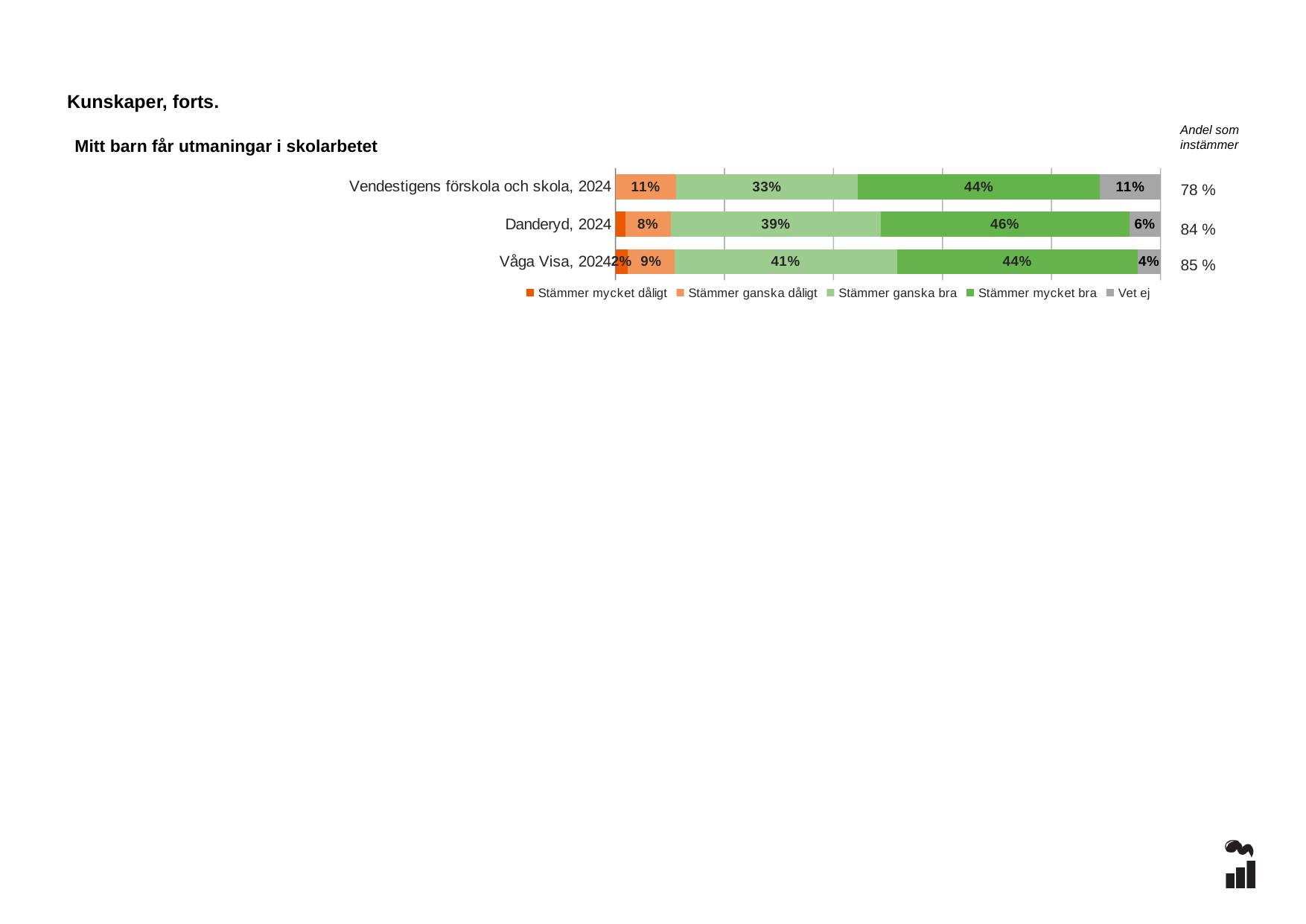
How many categories (bars) are shown in the chart? 3 What is the difference between the "Stämmer ganska bra" values for Våga Visa, 2024 and Vendestigens förskola och skola, 2024? 8 percentage points What is the "Stämmer ganska dåligt" value for Vendestigens förskola och skola, 2024? 11% What percentage of respondents for Vendestigens förskola och skola, 2024 answered "Stämmer mycket bra"? 44% Which is larger: the "Stämmer mycket bra" value for Danderyd, 2024 or for Våga Visa, 2024? Danderyd, 2024 What is the "Vet ej" value for Våga Visa, 2024? 4% What kind of chart is shown on the slide? Stacked bar chart How many series does the legend list? 5 Which category has the highest "Vet ej" share? Vendestigens förskola och skola, 2024 Which category has the lowest "Stämmer ganska bra" share? Vendestigens förskola och skola, 2024 What is the "Stämmer ganska bra" value for Danderyd, 2024? 39% What is the "Andel som instämmer" value shown for Danderyd, 2024? 84 %